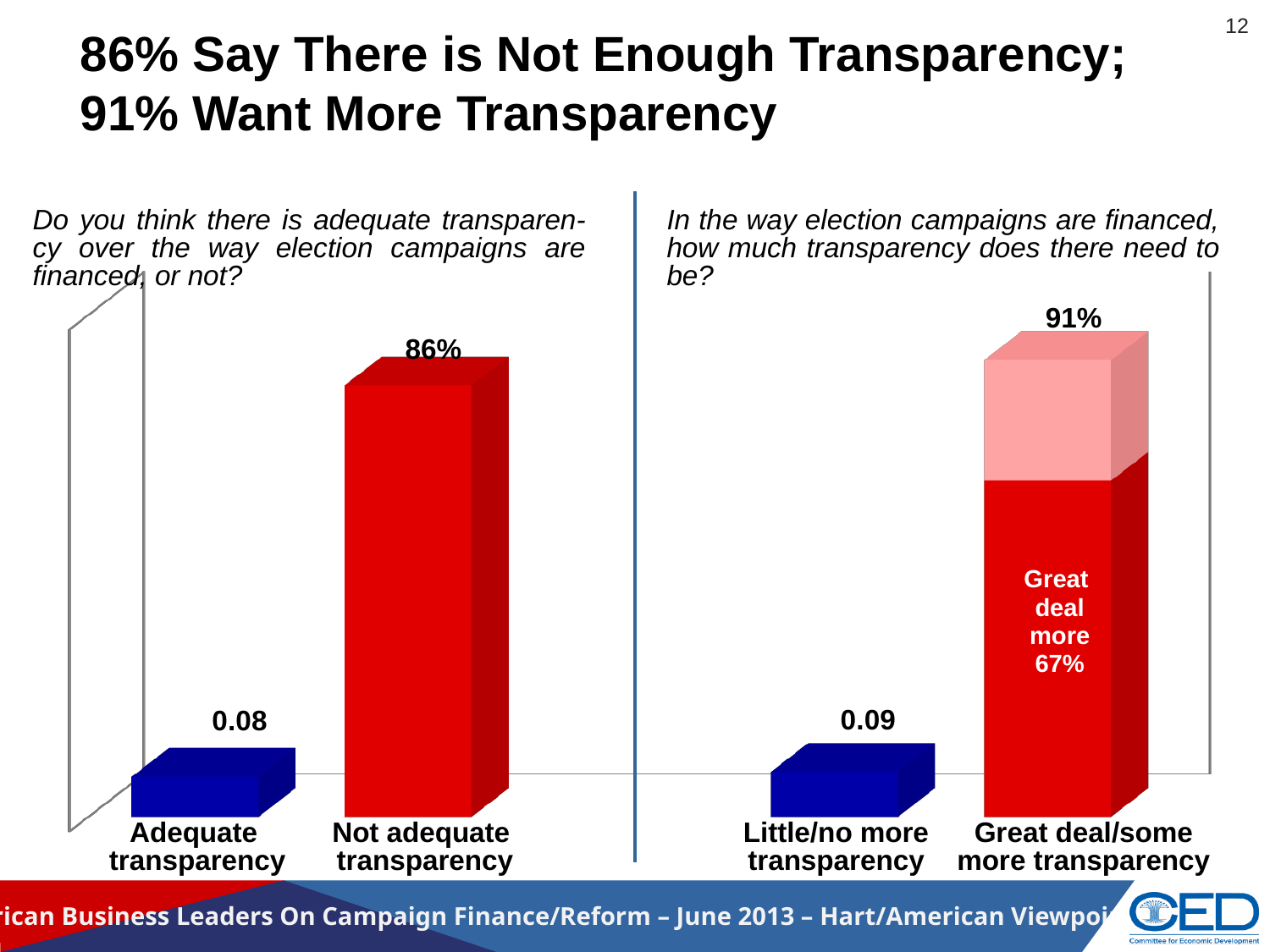
In the right chart, which category has the lowest value? Little/no more transparency What type of chart is used on the left side of the slide? Bar chart In the right chart, what is the total value shown for 'Great deal/some more transparency'? 91% In the left chart, what is the value shown for 'Not adequate transparency'? 86% In the right chart, what is the difference between the 91% total and the 67% 'Great deal more' segment? 24% In the right chart, what value is printed above the 'Little/no more transparency' bar? 0.09 In the right chart, which is larger: 'Little/no more transparency' or 'Great deal/some more transparency'? Great deal/some more transparency What colour is the 'Adequate transparency' bar in the left chart? Blue In the left chart, what value is printed above the 'Adequate transparency' bar? 0.08 In the right chart, what value is labelled for the 'Great deal more' segment of the stacked bar? 67% In the left chart, which category has the highest value? Not adequate transparency How many categories are shown in the left chart? 2